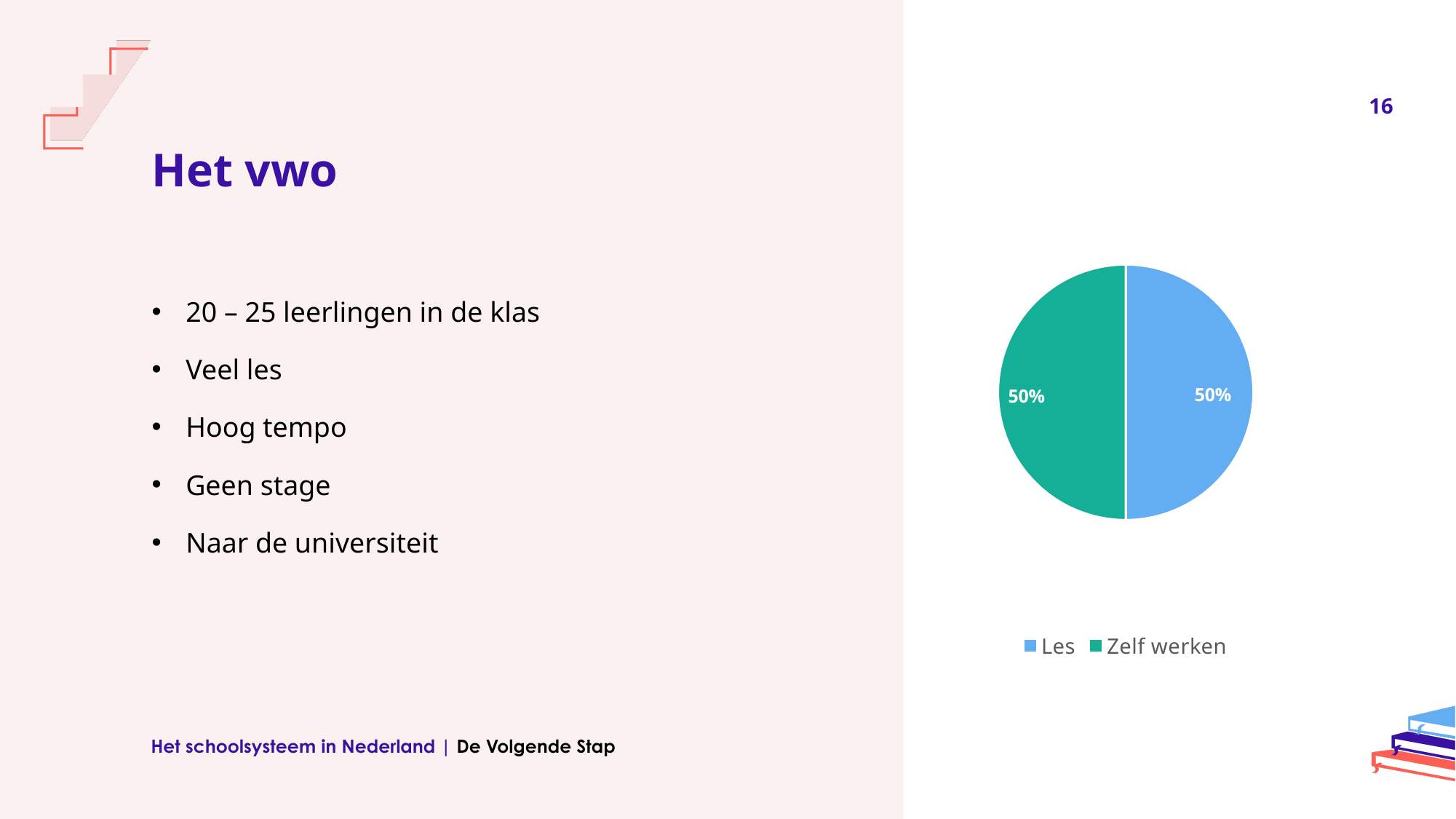
What share of the pie does "Les" take? 50% How many slices does the pie chart have? 2 What is the value shown for the "Zelf werken" slice? 50% What is the difference between the "Les" and "Zelf werken" slices? 0% Which legend entry is shown in green? Zelf werken How many entries does the legend list? 2 Which legend entry is shown in blue? Les What is the total of the two slices in the pie chart? 100% What is the value shown for the "Les" slice? 50% What share of the pie does "Zelf werken" take? 50% What kind of chart is shown on the slide? pie chart